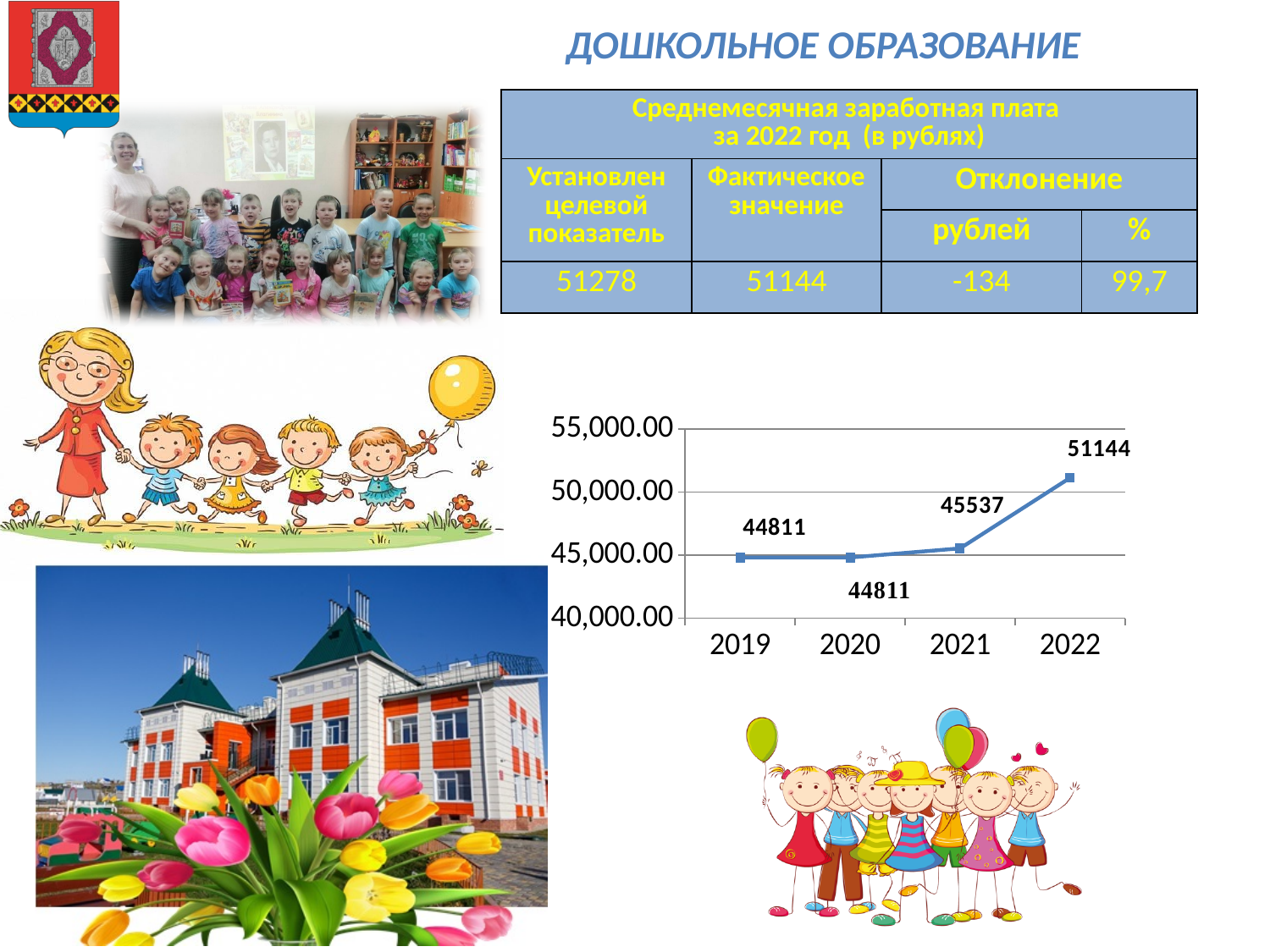
Which is larger on the line chart, the value for 2021 or the value for 2020? 2021 Which year has the highest value on the line chart? 2022 What is the value plotted for 2022 on the line chart? 51144 What is the difference between the 2022 and 2021 values on the line chart? 5607 How many years are plotted on the line chart? 4 What is the difference between the 2022 and 2019 values on the line chart? 6333 What is the value plotted for 2020 on the line chart? 44811 Is the value for 2022 on the line chart greater or less than 50,000.00? greater Do the values on the line chart rise or fall from 2019 to 2022? rise What is the value plotted for 2021 on the line chart? 45537 What is the value plotted for 2019 on the line chart? 44811 What kind of chart is shown on the slide? line chart